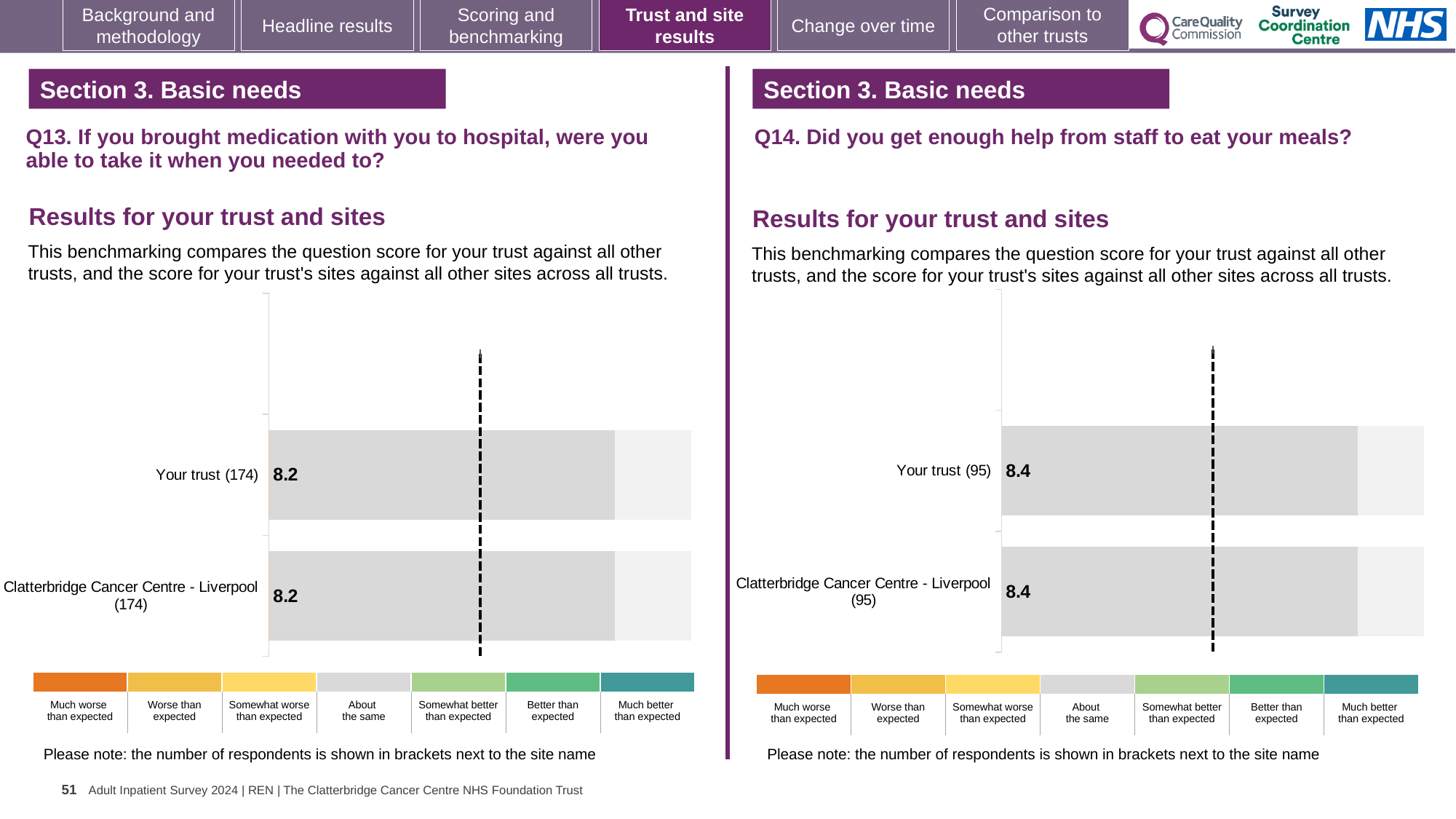
On the Q13 chart (left), what is the difference between the score for Your trust and the score for Clatterbridge Cancer Centre - Liverpool? 0 On the Q14 chart (right), what is the difference between the score for Your trust and the score for Clatterbridge Cancer Centre - Liverpool? 0 How many bars are plotted on the Q13 chart (left)? 2 On the Q13 chart (left), what is the score for Clatterbridge Cancer Centre - Liverpool? 8.2 On the Q13 chart (left), how many respondents are shown in brackets for Your trust? 174 On the Q14 chart (right), how many respondents are shown in brackets for Clatterbridge Cancer Centre - Liverpool? 95 On the Q13 chart (left), what is the score for Your trust? 8.2 On the Q14 chart (right), what is the score for Your trust? 8.4 What kind of chart is the Q13 chart (left)? Bar chart Is the score for Your trust on the Q14 chart (right) larger than the score for Your trust on the Q13 chart (left)? Yes How many bars are plotted on the Q14 chart (right)? 2 On the Q14 chart (right), what is the score for Clatterbridge Cancer Centre - Liverpool? 8.4